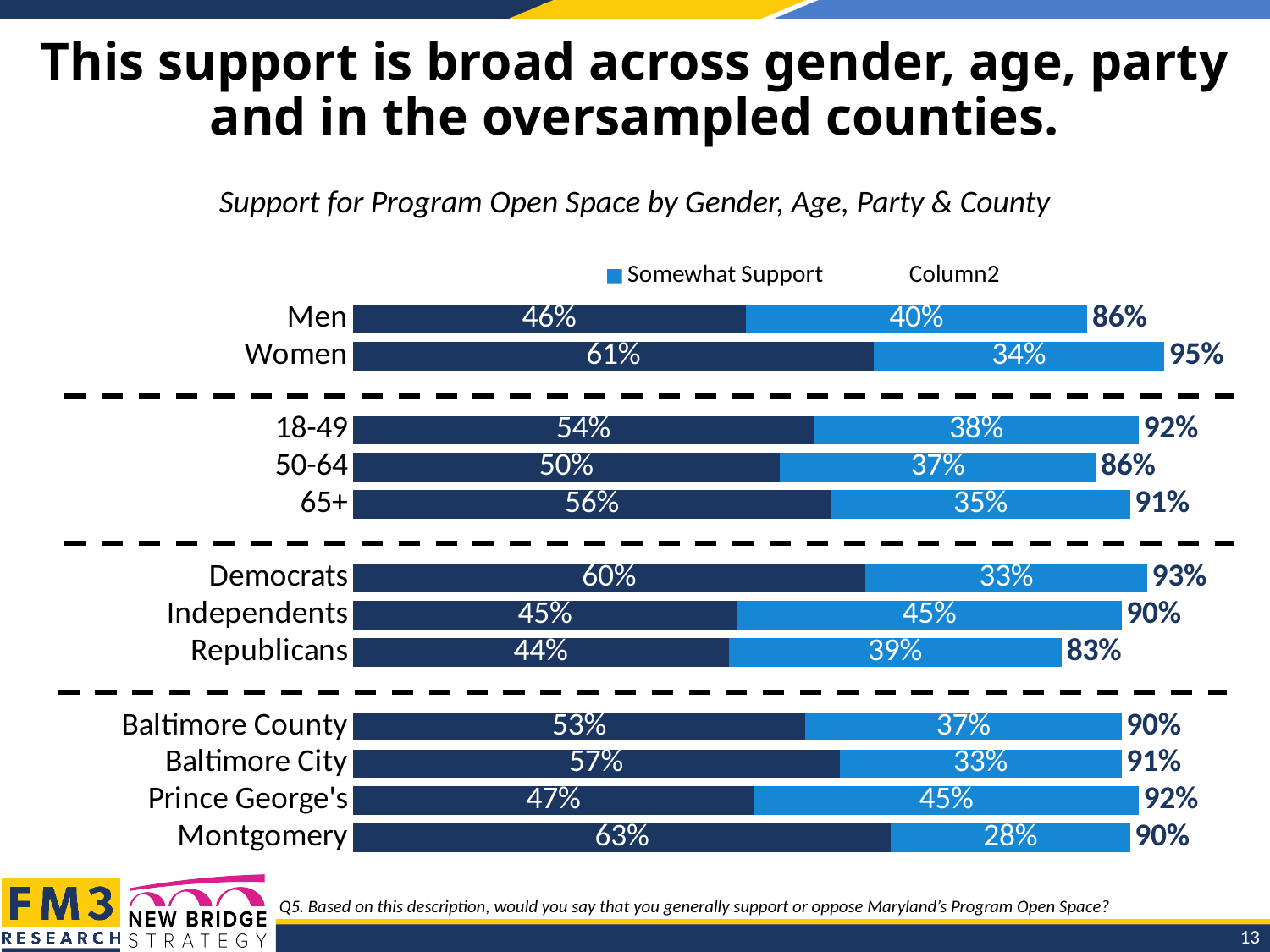
What is the Somewhat Support value for Men? 40% What is the Somewhat Support value for Independents? 45% What is the value of the dark blue segment for Montgomery? 63% What is the total support value printed at the end of the bar for Women? 95% What is the difference between the total support for Women and the total support for Men? 9 percentage points Which category has the lowest total support value? Republicans Which category has the highest total support value? Women What kind of chart is shown on the slide? Bar chart How many series does the legend list? 2 How many categories (bars) are plotted in the chart? 12 What is the title of the chart? Support for Program Open Space by Gender, Age, Party & County Which has a higher total support value, Democrats or Republicans? Democrats